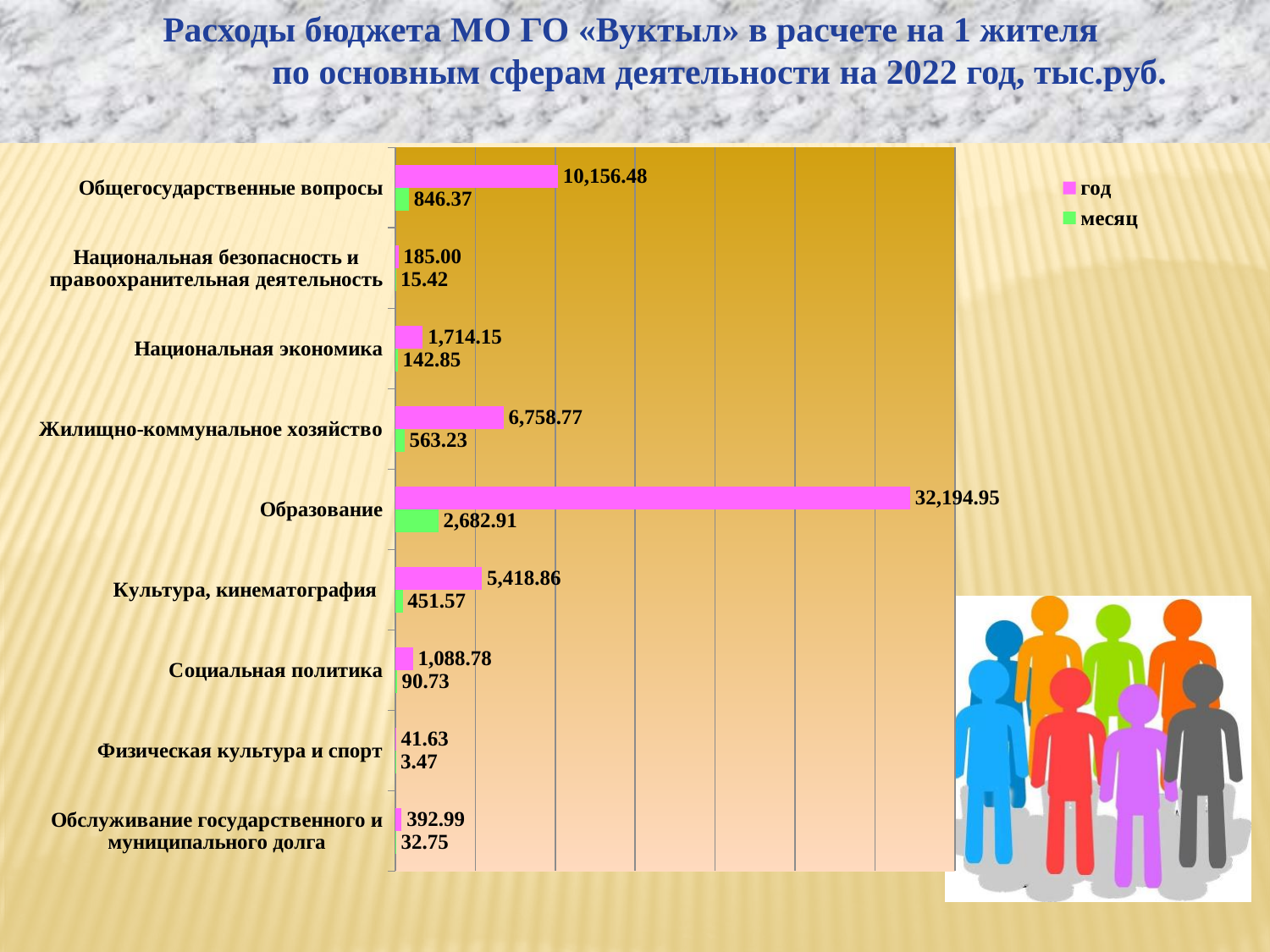
What is the value of the 'месяц' series for 'Физическая культура и спорт'? 3.47 How many categories are shown on the chart? 9 What is the value of the 'год' series for 'Образование'? 32,194.95 What is the value of the 'год' series for 'Культура, кинематография'? 5,418.86 Which category has the lowest value in the 'месяц' series? Физическая культура и спорт What is the difference between the 'год' values for 'Общегосударственные вопросы' and 'Жилищно-коммунальное хозяйство'? 3,397.71 Which is larger in the 'год' series: 'Национальная экономика' or 'Социальная политика'? Национальная экономика What type of chart is shown on the slide? bar chart Which category has the highest value in the 'год' series? Образование What are the two legend entries of the chart? год, месяц What is the value of the 'месяц' series for 'Жилищно-коммунальное хозяйство'? 563.23 How many series does the legend list? 2